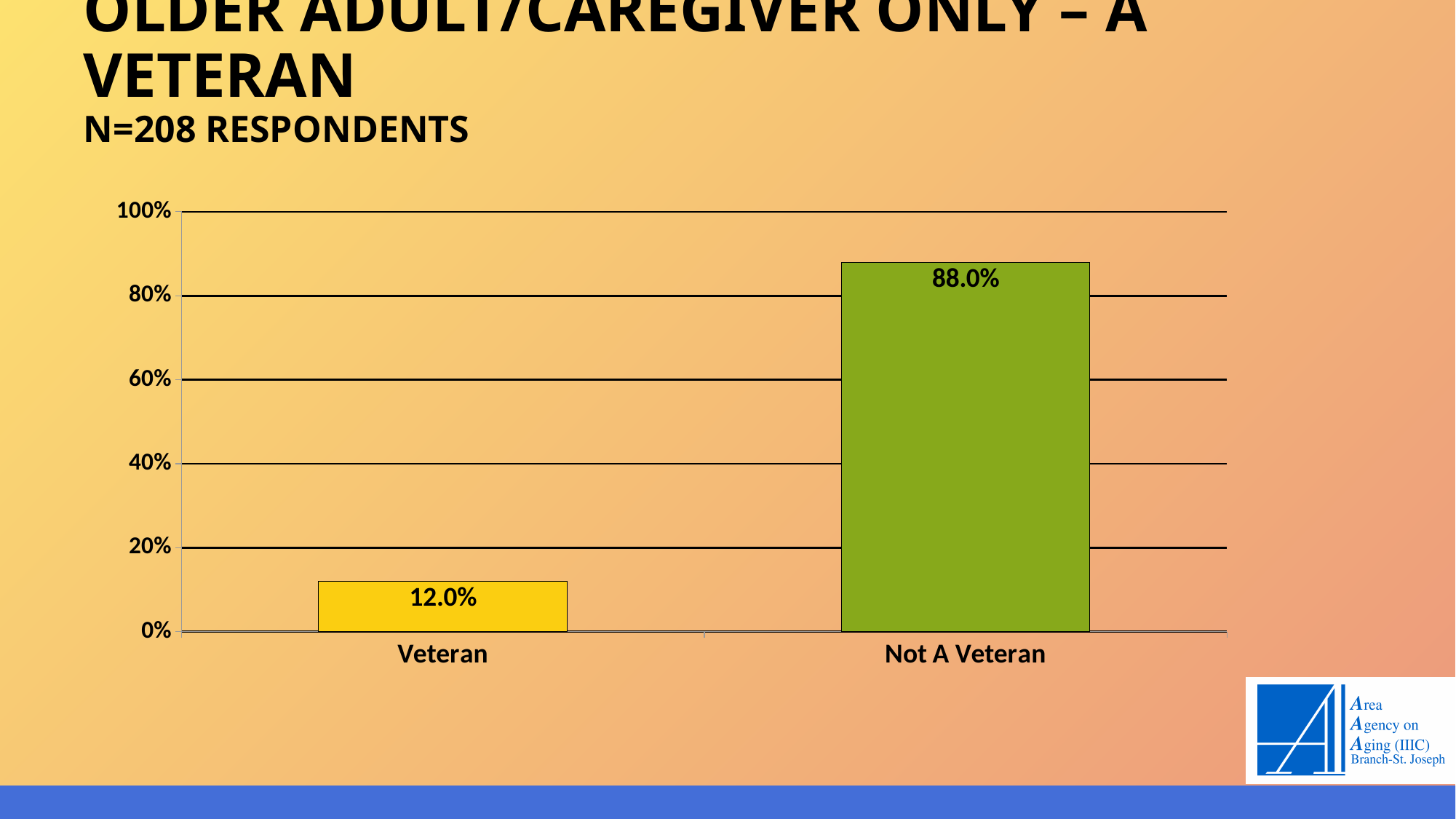
Which category has the lowest value? Veteran How many categories are shown on the x axis? 2 Is the value for Not A Veteran greater or less than 80%? greater How many respondents does the slide say the chart is based on? 208 Is the value for Veteran greater or less than 20%? less What is the difference between the values for Not A Veteran and Veteran? 76.0% Which category has the highest value? Not A Veteran Which is larger, the value for Veteran or the value for Not A Veteran? Not A Veteran What is the value for Not A Veteran? 88.0% What is the total of the two bar values? 100.0% What is the value for Veteran? 12.0% What kind of chart is shown on the slide? bar chart